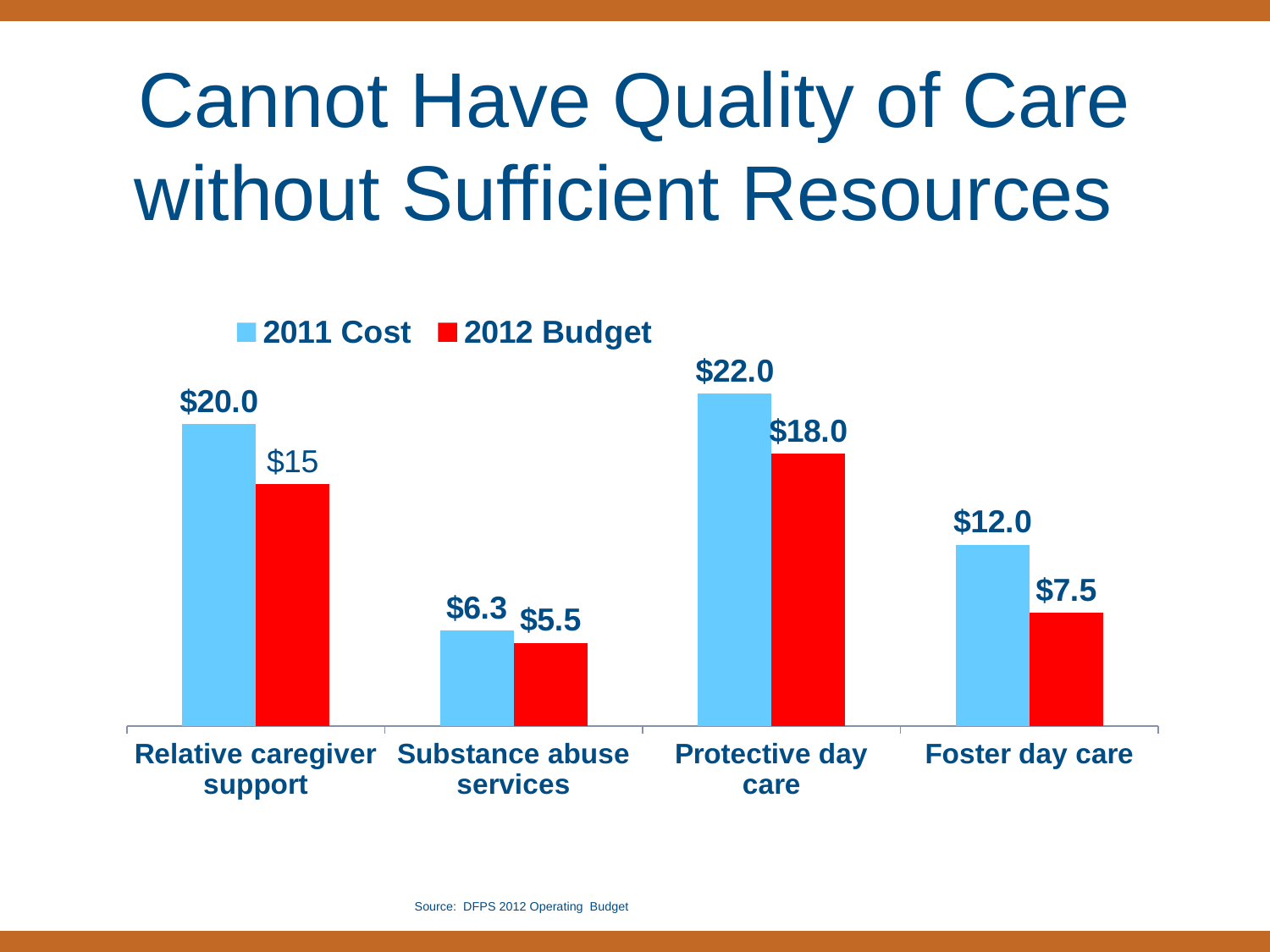
What is the 2012 Budget for Relative caregiver support? $15 What kind of chart is shown on the slide? Bar chart Which category has the lowest 2012 Budget? Substance abuse services How many series does the legend list? 2 What is the difference between the 2011 Cost and the 2012 Budget for Foster day care? $4.5 What is the 2011 Cost for Protective day care? $22.0 How many categories are shown on the x axis? 4 What is the 2012 Budget for Foster day care? $7.5 What is the difference between the 2011 Cost and the 2012 Budget for Protective day care? $4.0 Which category has the highest 2011 Cost? Protective day care Which is larger, the 2012 Budget for Relative caregiver support or the 2012 Budget for Foster day care? Relative caregiver support What is the 2011 Cost for Substance abuse services? $6.3